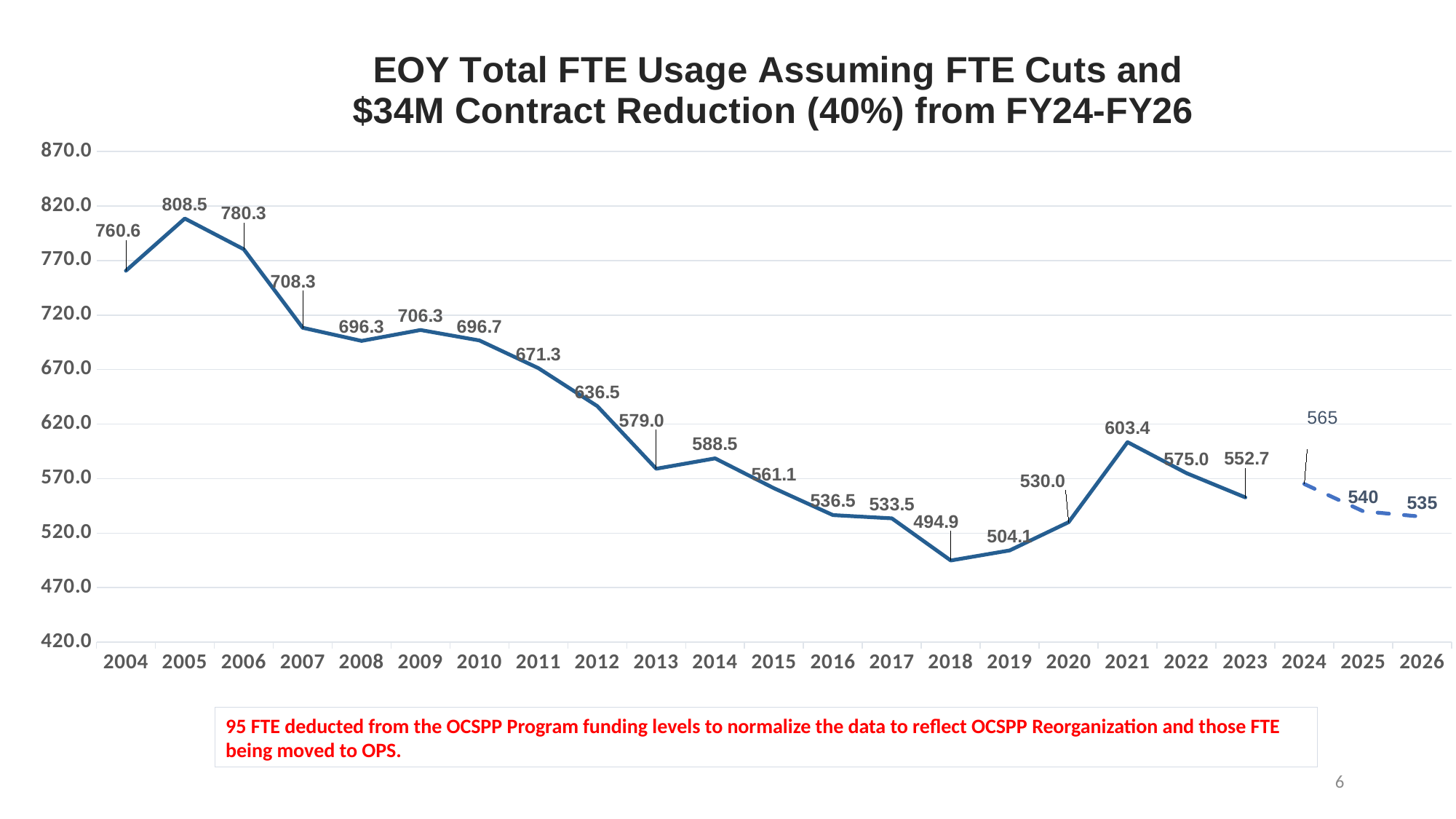
How many years are shown on the x axis? 23 What is the difference between the values for 2022 and 2023? 22.3 Is the value for 2011 greater or less than 670.0? greater Which year has the highest value? 2005 What is the projected value for 2026? 535 What kind of chart is this? line chart What is the value for 2005? 808.5 What is the value for 2021? 603.4 What is the difference between the values for 2004 and 2005? 47.9 Which is larger, the value for 2013 or the value for 2014? 2014 What is the value for 2018? 494.9 Which year has the lowest value? 2018